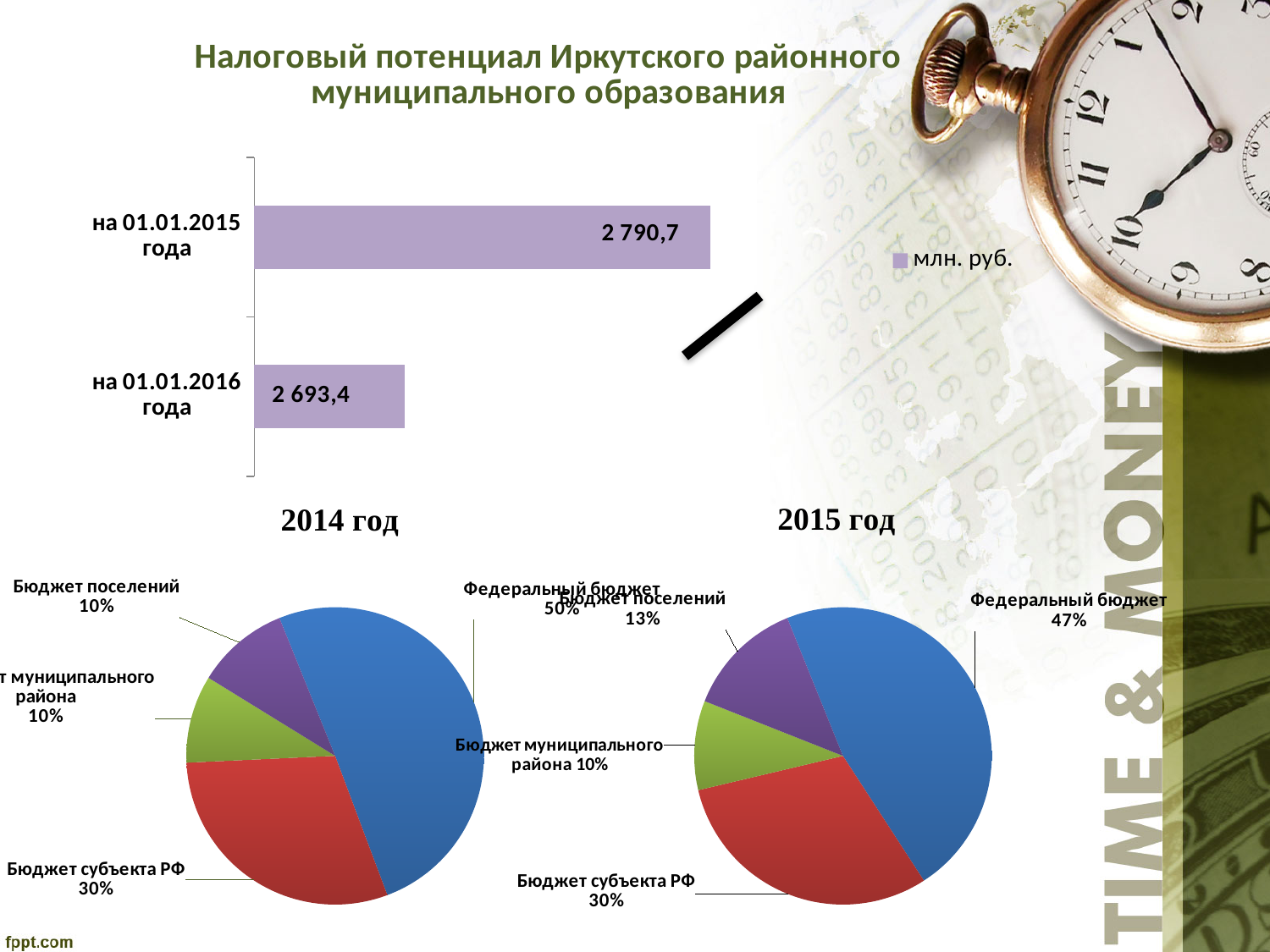
In the '2015 год' pie chart, what share does 'Бюджет поселений' have? 13% In the '2015 год' pie chart, what share does 'Федеральный бюджет' have? 47% In the bar chart at the top of the slide, what is the value for 'на 01.01.2016 года'? 2 693,4 In the bar chart at the top of the slide, what unit does the legend give for the series? млн. руб. How many slices does the '2015 год' pie chart have? 4 What kind of chart is the chart at the top of the slide? bar chart In the bar chart at the top of the slide, which category has the higher value? на 01.01.2015 года In the bar chart at the top of the slide, what is the value for 'на 01.01.2015 года'? 2 790,7 In the '2015 год' pie chart, which slice is the largest? Федеральный бюджет In the '2014 год' pie chart, what share does 'Бюджет субъекта РФ' have? 30% In the bar chart at the top of the slide, what is the difference between the values for 'на 01.01.2015 года' and 'на 01.01.2016 года'? 97,3